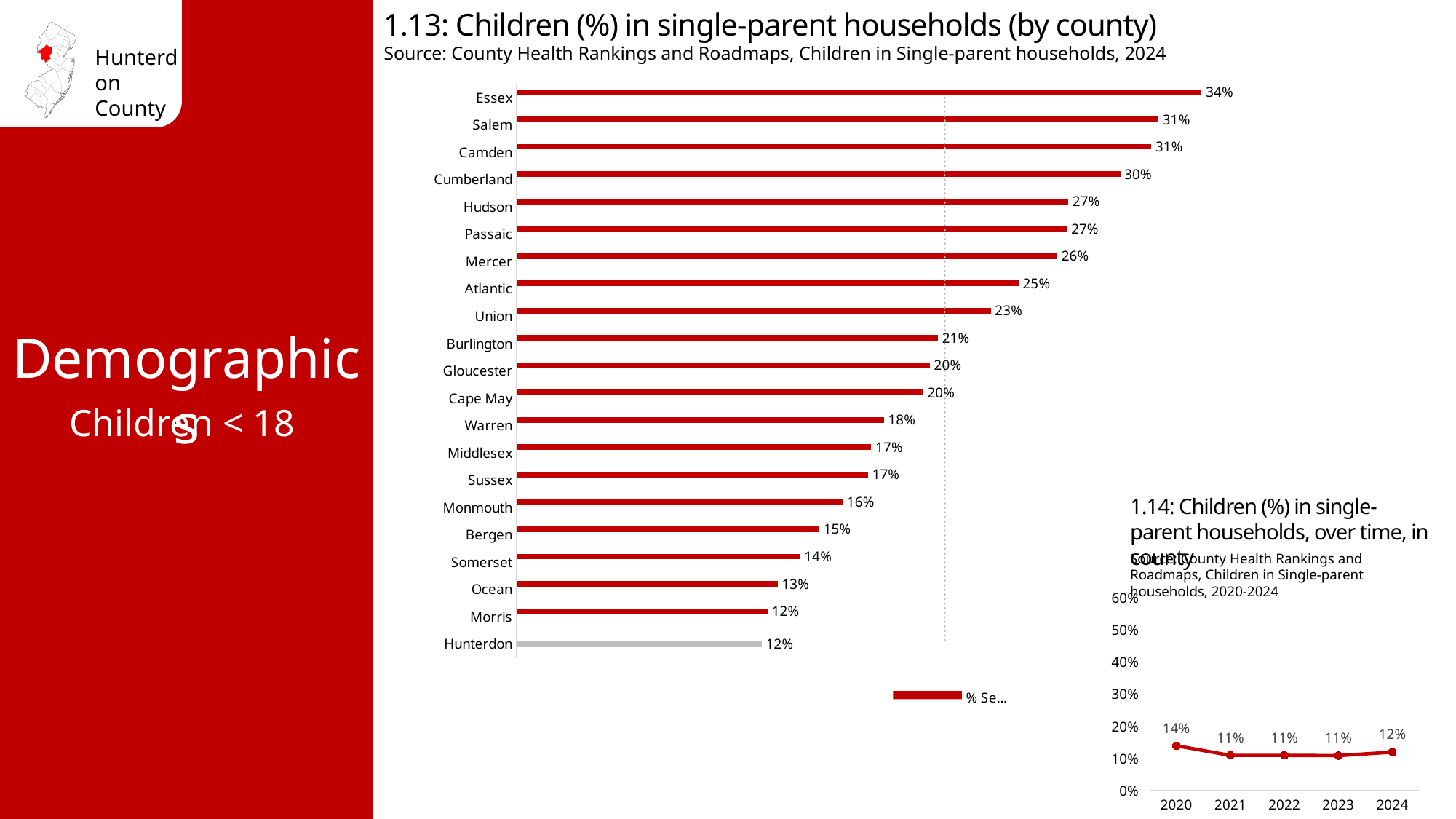
In chart 1.13, what is the value for Cumberland? 30% In chart 1.13, how many counties are shown? 21 In chart 1.13 (Children in single-parent households by county), what is the value for Essex? 34% In chart 1.13, what is the difference between the values for Essex and Hunterdon? 22 percentage points In chart 1.14, what is the value for 2024? 12% What kind of chart is chart 1.14? Line chart In chart 1.14, how many years are plotted? 5 In chart 1.13, what is the value for Hunterdon? 12% In chart 1.13, which county has the highest percentage of children in single-parent households? Essex What kind of chart is chart 1.13? Bar chart In chart 1.14 (Children in single-parent households over time), what is the value for 2020? 14% In chart 1.13, which is larger, the value for Hudson or the value for Union? Hudson